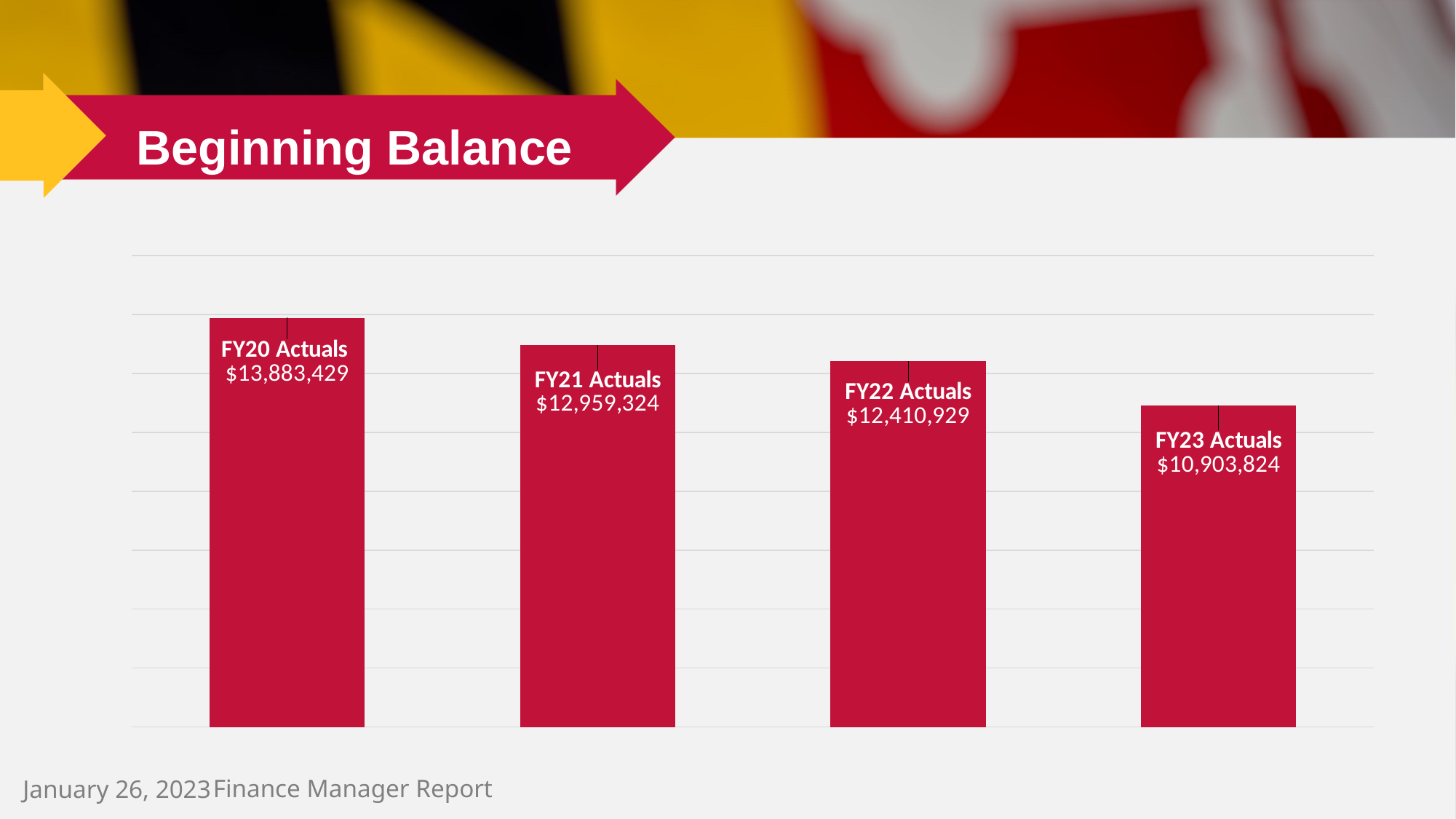
How many bars are shown in the chart? 4 Which is larger, FY21 Actuals or FY22 Actuals? FY21 Actuals What is the value for FY22 Actuals? $12,410,929 What is the difference between FY22 Actuals and FY23 Actuals? $1,507,105 What kind of chart is shown on the slide? Bar chart Which category has the lowest value? FY23 Actuals Which category has the highest value? FY20 Actuals What is the value for FY23 Actuals? $10,903,824 What is the value for FY20 Actuals? $13,883,429 What is the difference between FY20 Actuals and FY21 Actuals? $924,105 Do the values rise or fall from FY20 Actuals to FY23 Actuals? Fall What is the value for FY21 Actuals? $12,959,324